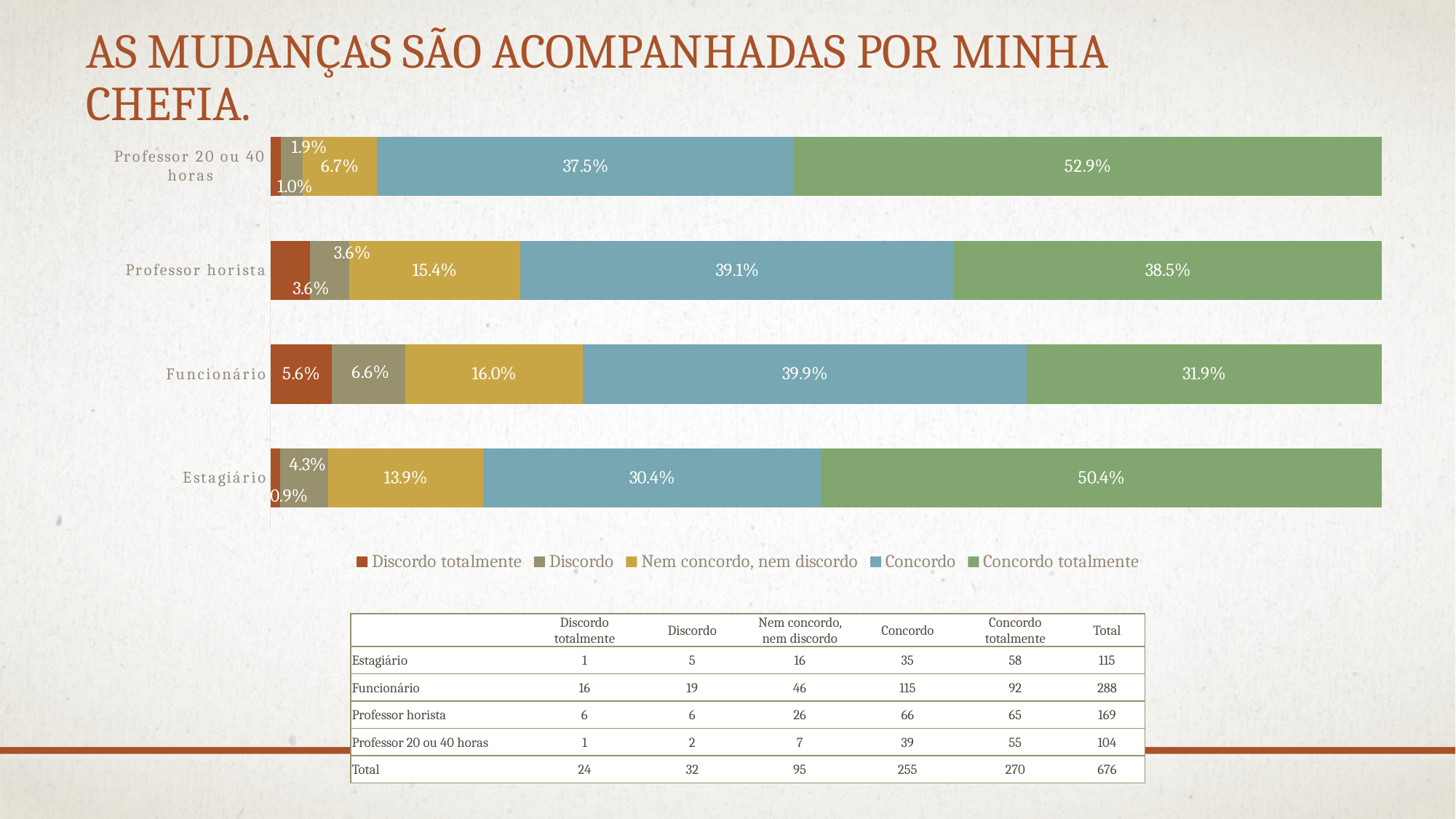
Which category has the highest Concordo totalmente value? Professor 20 ou 40 horas Which category has the lowest Discordo totalmente value? Estagiário What is the value of Discordo for Estagiário? 4.3% What is the difference between the Concordo values for Funcionário and Estagiário? 9.5 percentage points What is the title of the slide? AS MUDANÇAS SÃO ACOMPANHADAS POR MINHA CHEFIA. What is the value of Concordo totalmente for Professor 20 ou 40 horas? 52.9% Which category has the highest Nem concordo, nem discordo value? Funcionário How many categories are shown on the chart? 4 What kind of chart is shown on the slide? Stacked bar chart What is the value of Nem concordo, nem discordo for Funcionário? 16.0% For Professor horista, which is larger: Concordo or Concordo totalmente? Concordo How many series does the legend list? 5